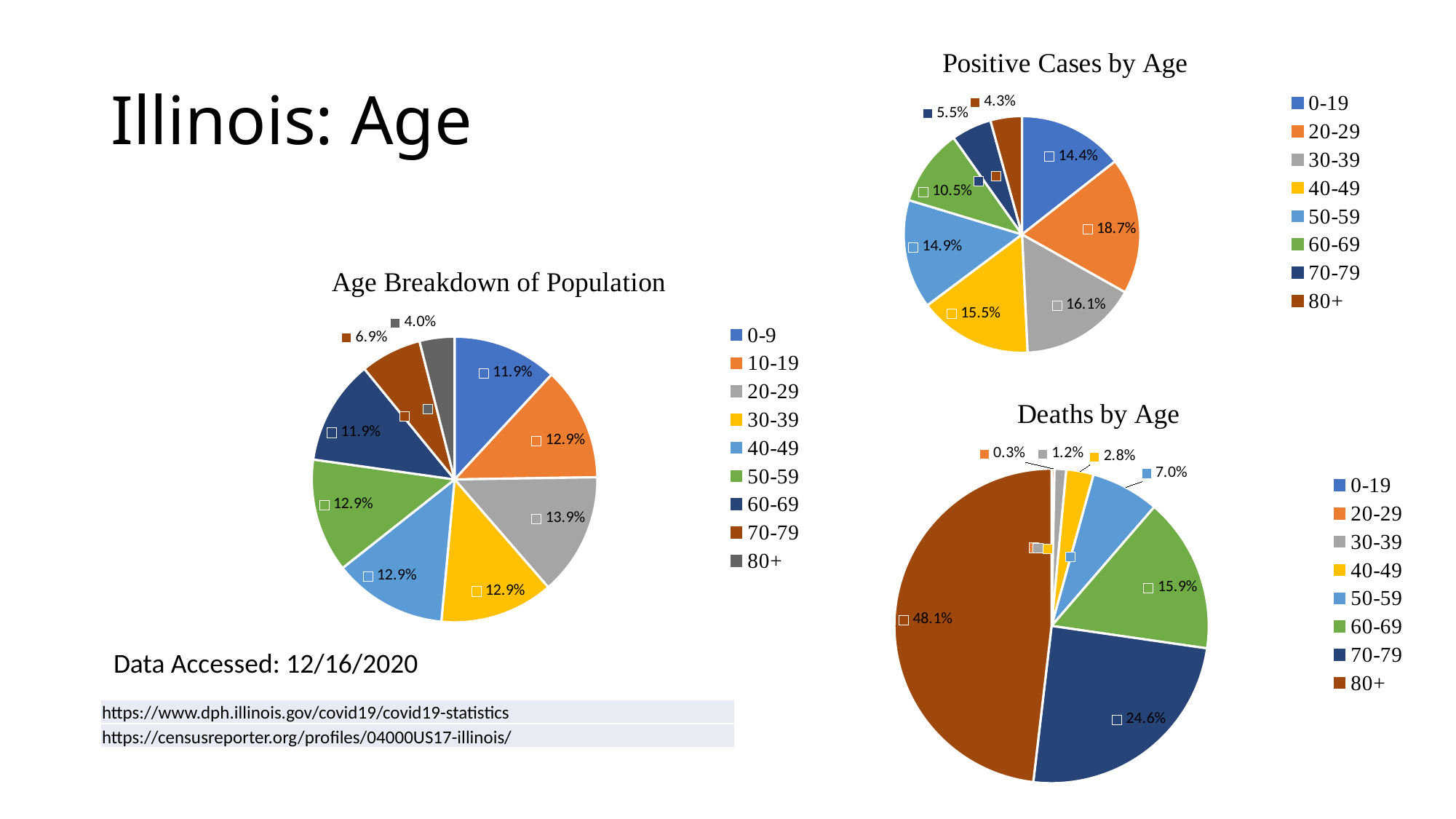
In the Positive Cases by Age chart, which is larger: the share for 40-49 or the share for 50-59? 40-49 In the Deaths by Age chart, what is the difference between the shares for 80+ and 70-79? 23.5% How many age groups does the legend of the Age Breakdown of Population chart list? 9 In the Positive Cases by Age chart, which age group has the largest share of cases? 20-29 In the Deaths by Age chart, what percentage of deaths are in the 70-79 age group? 24.6% In the Age Breakdown of Population chart, which age group has the smallest share? 80+ In the Deaths by Age chart, what percentage of deaths are in the 80+ age group? 48.1% In the Positive Cases by Age chart, what percentage of positive cases are in the 20-29 age group? 18.7% In the Age Breakdown of Population chart, what share of the population is aged 20-29? 13.9% What type of chart is Deaths by Age? Pie chart How many age groups does the legend of the Deaths by Age chart list? 8 In the Positive Cases by Age chart, what is the difference between the shares for 30-39 and 60-69? 5.6%